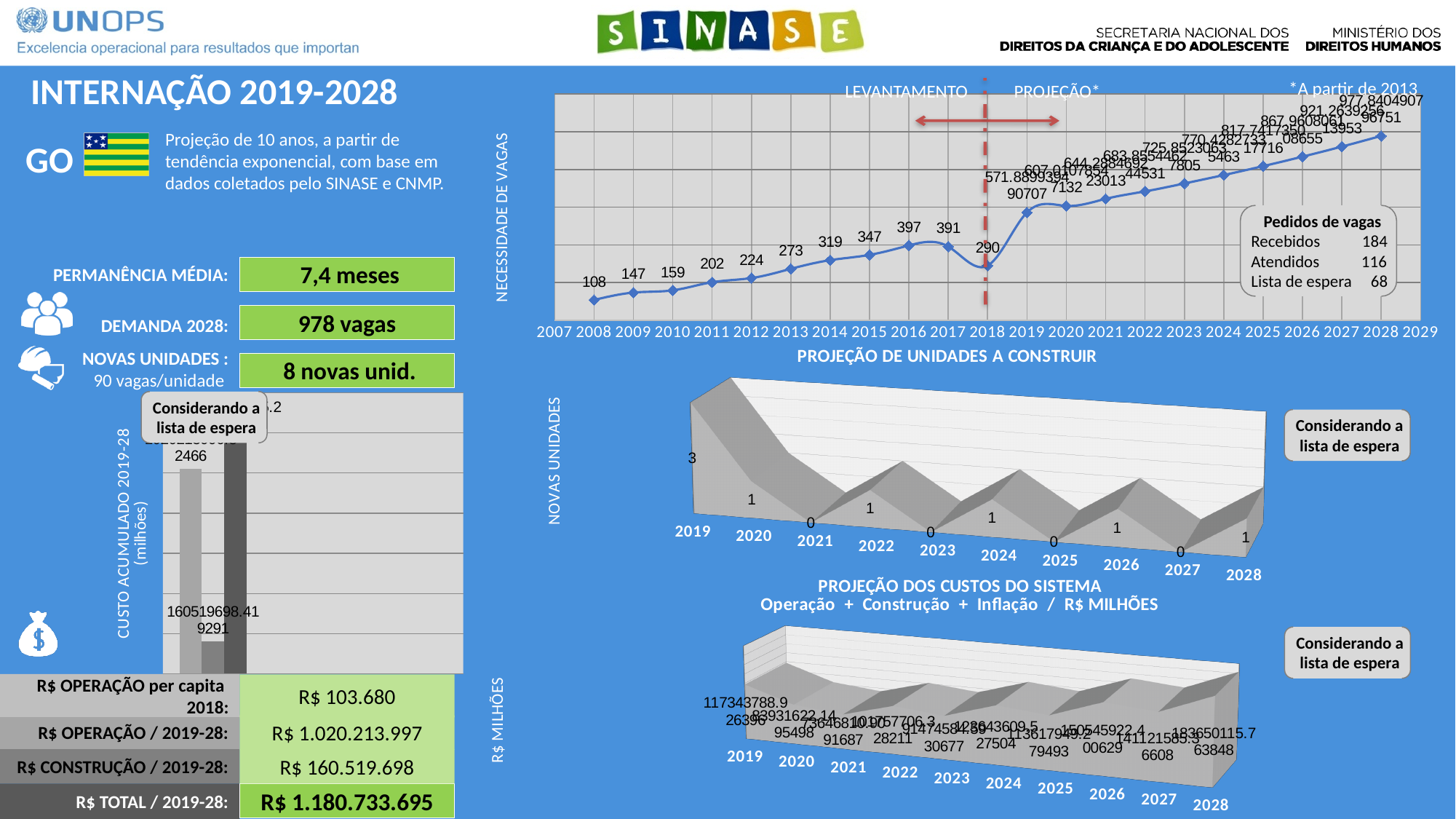
In the top-right line chart, what value is shown for 'Lista de espera' in the 'Pedidos de vagas' box? 68 In the top-right line chart (NECESSIDADE DE VAGAS), what is the value for 2016? 397 In the top-right line chart (NECESSIDADE DE VAGAS), which year has the highest value? 2028 In the chart titled PROJEÇÃO DE UNIDADES A CONSTRUIR, what is the difference between the values for 2019 and 2020? 2 In the top-right line chart (NECESSIDADE DE VAGAS), which is larger, the value for 2017 or the value for 2018? 2017 In the top-right line chart (NECESSIDADE DE VAGAS), which year has the lowest value? 2008 In the top-right line chart (NECESSIDADE DE VAGAS), what is the value for 2018? 290 In the top-right line chart (NECESSIDADE DE VAGAS), what is the difference between the values for 2016 and 2017? 6 In the chart titled PROJEÇÃO DE UNIDADES A CONSTRUIR, how many years are shown on the x axis? 10 In the top-right line chart (NECESSIDADE DE VAGAS), what is the value for 2008? 108 In the chart titled PROJEÇÃO DE UNIDADES A CONSTRUIR, what is the value for 2019? 3 In the top-right line chart (NECESSIDADE DE VAGAS), do the values rise or fall from 2008 to 2016? rise